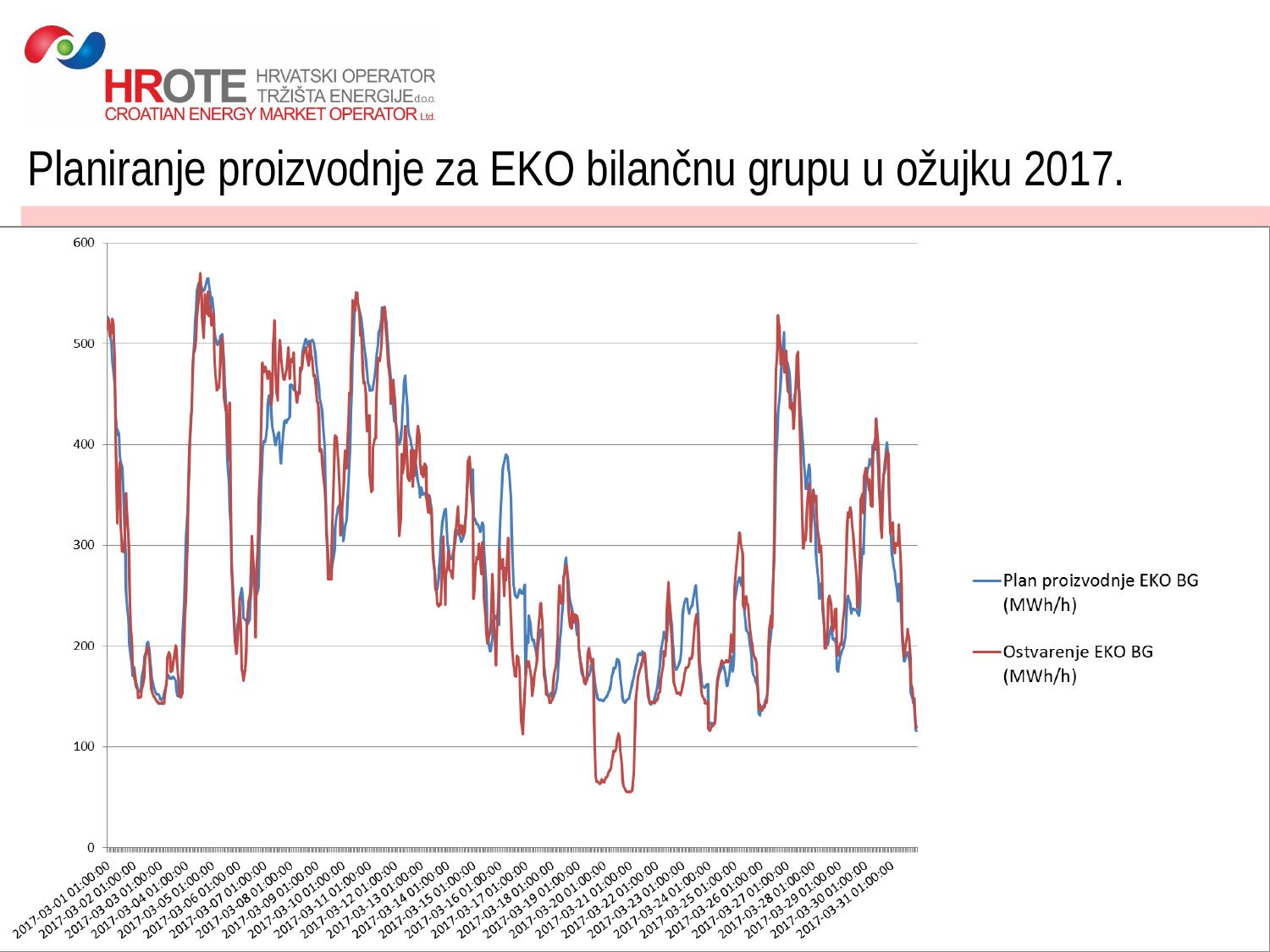
Which series is drawn in red? Ostvarenje EKO BG (MWh/h) Is the value of Plan proizvodnje EKO BG around 2017-03-21 01:00:00 greater or less than 100? greater Do the values of Ostvarenje EKO BG rise or fall between 2017-03-28 01:00:00 and 2017-03-31 01:00:00? fall How many series does the legend list? 2 What kind of chart is shown on the slide? Line chart Which series is drawn in blue? Plan proizvodnje EKO BG (MWh/h) What is the highest value shown on the vertical axis? 600 Is the value of Ostvarenje EKO BG at the end of the series (2017-03-31) greater or less than 200? less Is the value of Plan proizvodnje EKO BG around 2017-03-03 01:00:00 greater or less than 300? less